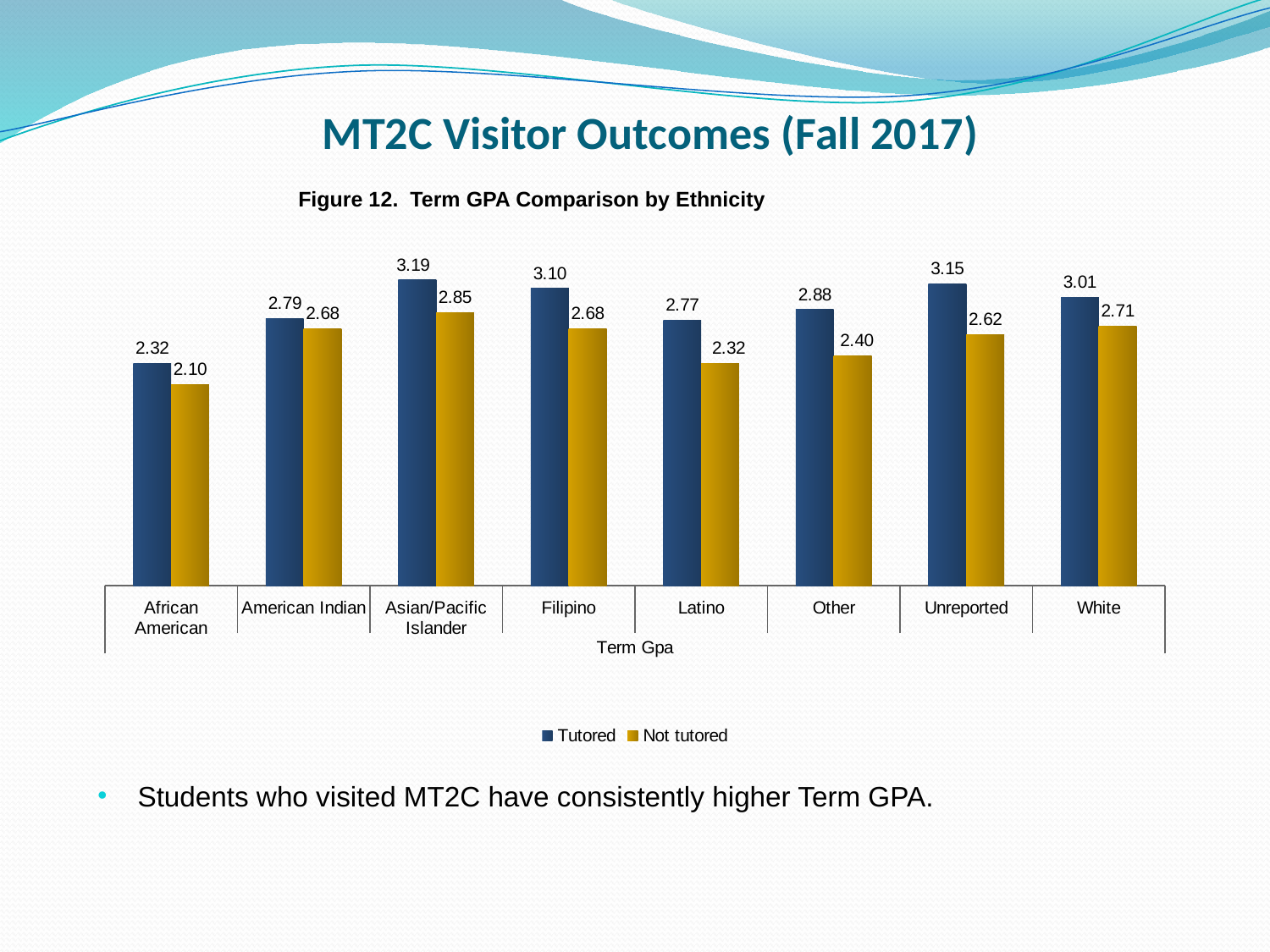
How many series does the legend list? 2 Which is larger, the Tutored Term GPA for Filipino or the Tutored Term GPA for White? Filipino What is the difference between the Tutored and Not tutored Term GPA for Unreported? 0.53 What is the Tutored Term GPA for Asian/Pacific Islander students? 3.19 What is the Not tutored Term GPA for Latino students? 2.32 Which ethnicity has the highest Tutored Term GPA? Asian/Pacific Islander What is the title of the figure? Figure 12. Term GPA Comparison by Ethnicity What kind of chart is shown on the slide? Bar chart What is the Not tutored Term GPA for Other? 2.40 How many ethnicity categories are shown on the x axis? 8 Which ethnicity has the lowest Not tutored Term GPA? African American Which series is shown in gold/yellow bars? Not tutored